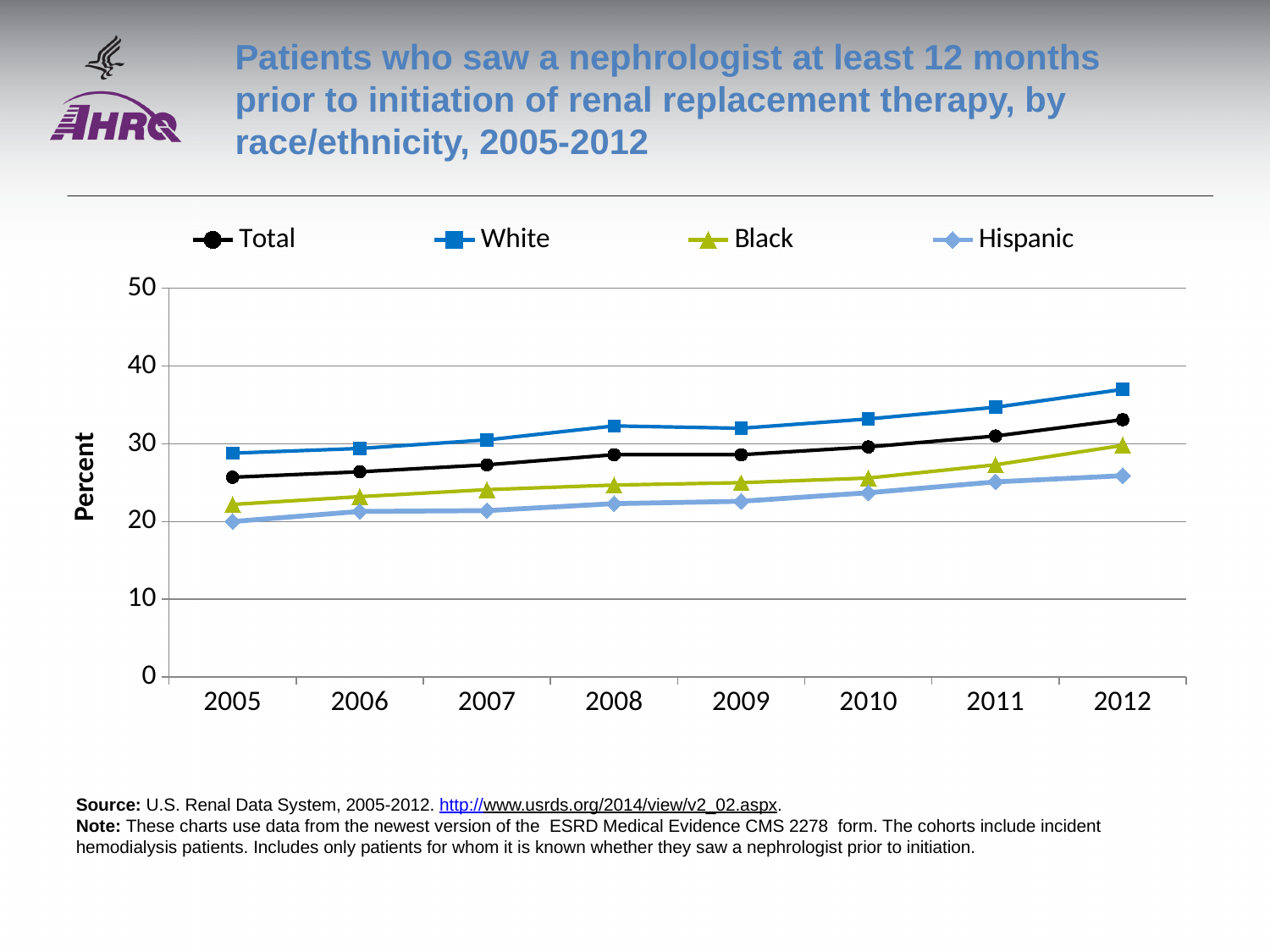
What is the label on the y axis? Percent Which race/ethnicity group has the highest value in 2012? White Is the value for White in 2012 greater or less than 40? less Is the value for White in 2012 greater or less than 30? greater Which is larger in 2008, the value for White or the value for Black? White Do the values for the Total series rise or fall from 2005 to 2012? rise Which race/ethnicity group has the lowest value in 2005? Hispanic In which year is the Total series at its highest? 2012 What kind of chart is shown on the slide? line chart How many years are plotted along the x axis? 8 Is the value for Hispanic in 2012 greater or less than 30? less How many series does the legend list? 4